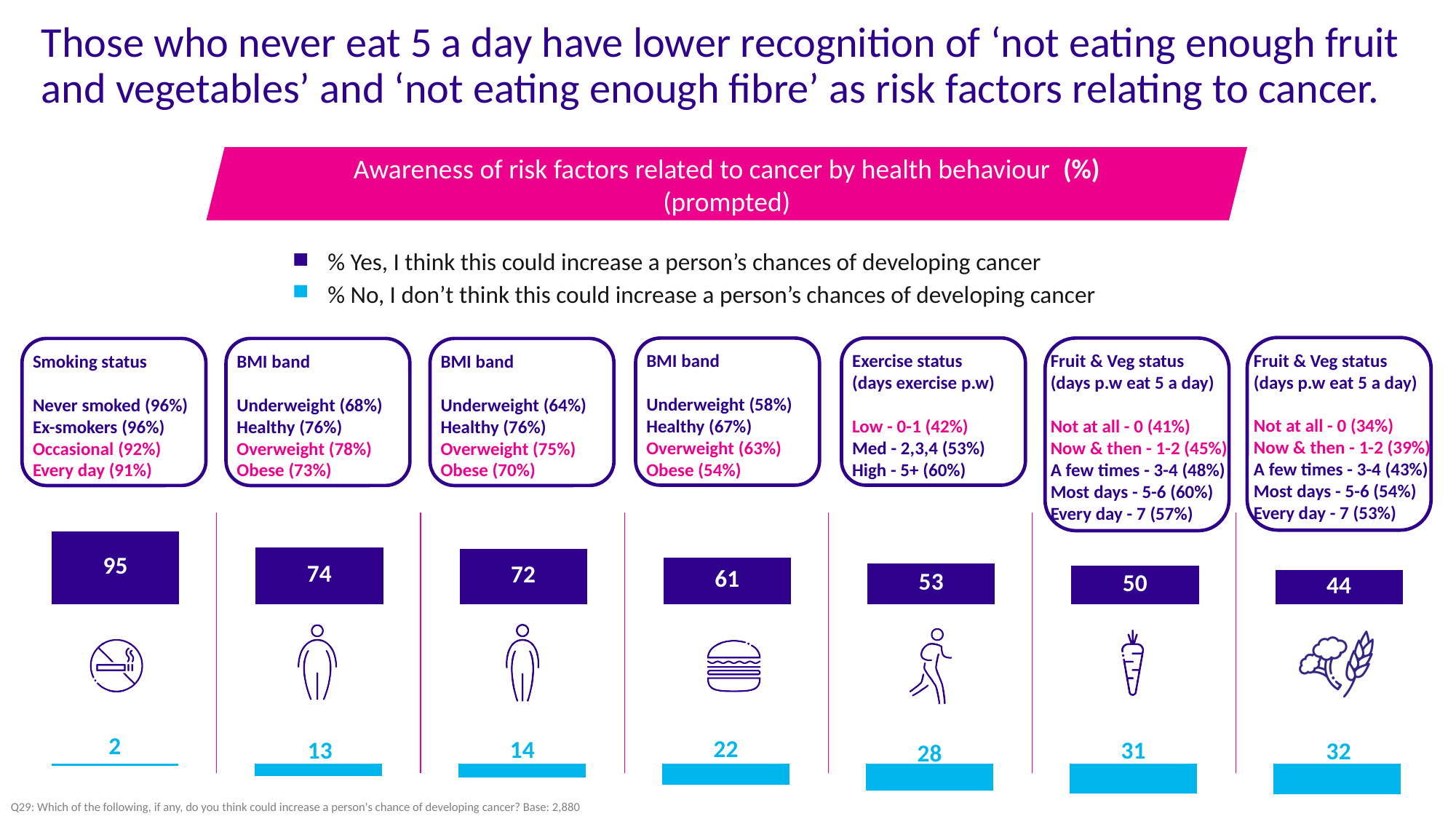
How many columns (risk factors) are plotted in the chart? 7 What is the '% No' value for the last column on the right (the broccoli and wheat icon)? 32 Which column has the lowest '% Yes' value? The last column (broccoli and wheat icon), 44 Which is larger: the '% No' value for the burger-icon column or the '% No' value for the walking-person column? The walking-person column (28) What is the '% Yes' value for the column with the burger icon? 61 Which column has the highest '% Yes' value? The first column (no-smoking icon), 95 What is the '% Yes' value for the first column on the left (the no-smoking icon)? 95 What kind of chart is shown on the slide? Bar chart Do the '% Yes' values rise or fall moving from the left column to the right column? Fall How many series does the legend list? 2 What is the difference between the highest '% Yes' value (95) and the lowest '% Yes' value (44)? 51 What is the '% No' value for the first column on the left (the no-smoking icon)? 2